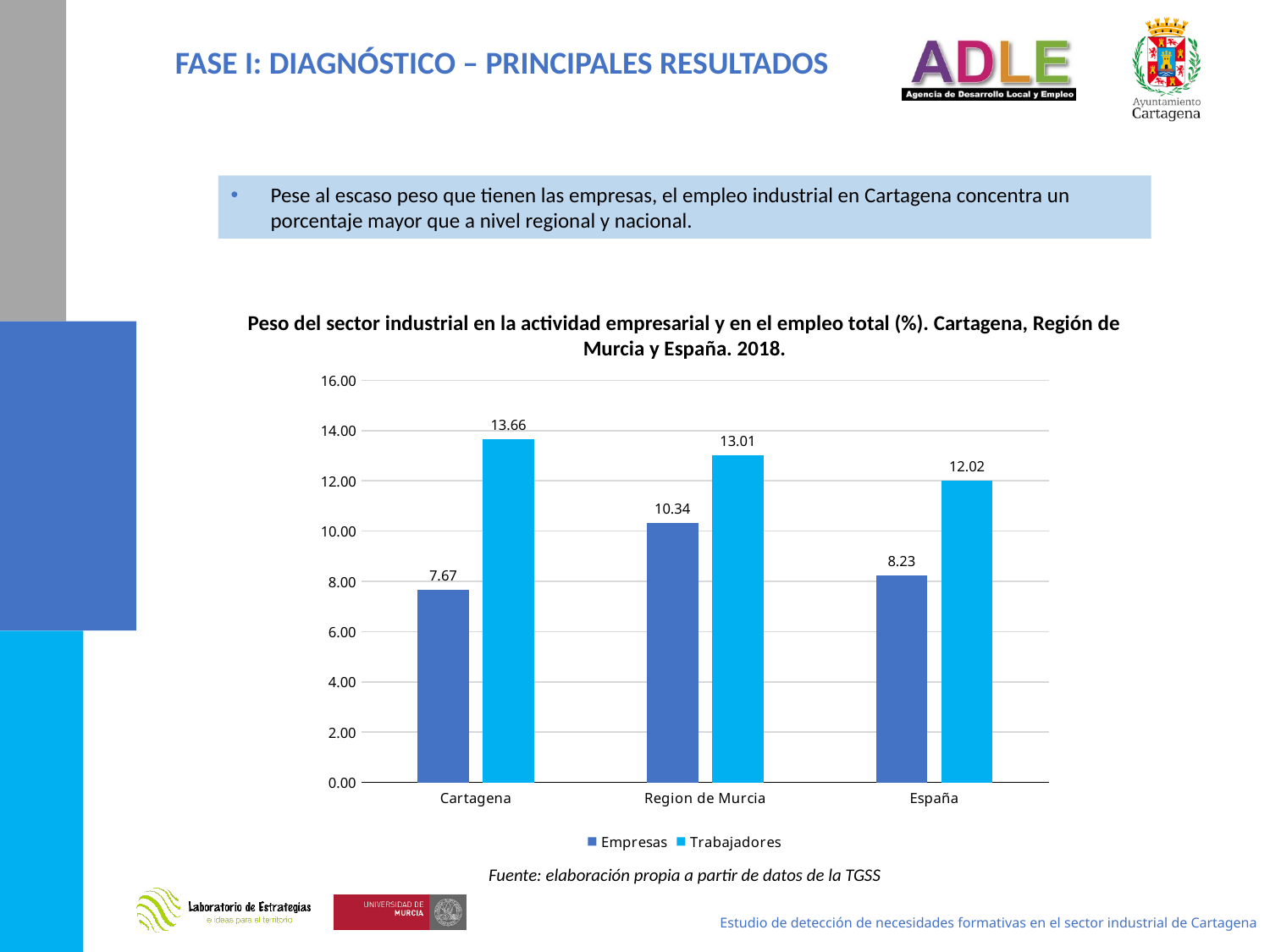
Which category has the lowest value for Trabajadores? España What is the value for Trabajadores in España? 12.02 What is the value for Empresas in Cartagena? 7.67 Which is larger: Empresas in España or Empresas in Cartagena? Empresas in España What kind of chart is shown on the slide? Bar chart How many series does the legend list? 2 What is the value for Trabajadores in Region de Murcia? 13.01 How many categories are shown on the x axis? 3 Is the value for Trabajadores in Cartagena greater or less than 14.00? less What is the difference between Trabajadores and Empresas in Cartagena? 5.99 What is the difference between the Empresas values for Region de Murcia and Cartagena? 2.67 Which category has the highest value for Empresas? Region de Murcia